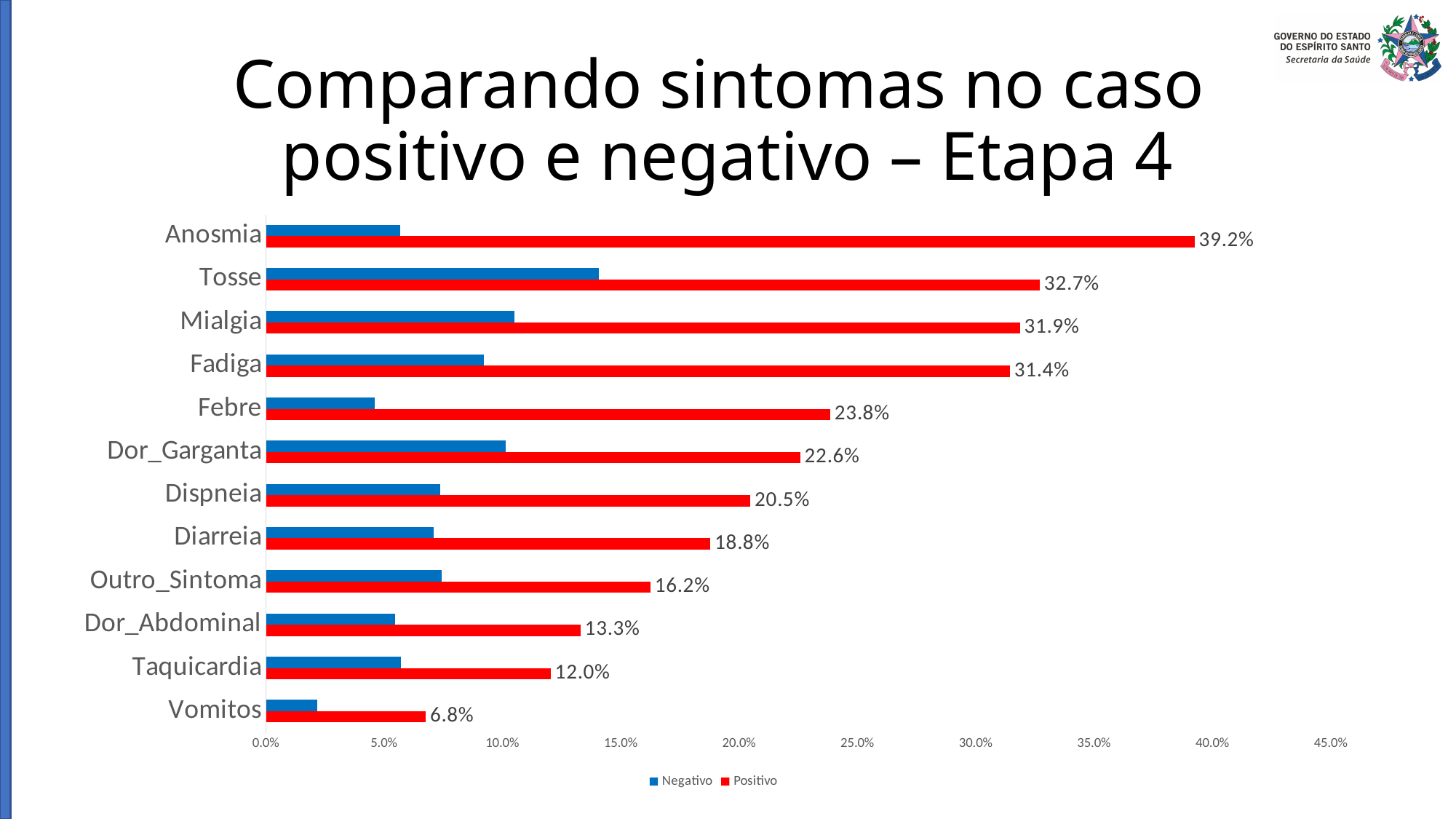
Is the Negativo value for Vomitos greater or less than 5.0%? less Is the Negativo value for Tosse greater or less than 10.0%? greater Which has a larger Positivo value, Dispneia or Diarreia? Dispneia How many symptoms are listed on the chart? 12 What kind of chart is shown on the slide? Bar chart Which symptom has the lowest Positivo value? Vomitos What is the Positivo value for Febre? 23.8% How many series does the legend list? 2 What is the difference between the Positivo values for Anosmia and Tosse? 6.5% What is the Positivo value for Vomitos? 6.8% Which symptom has the highest Positivo value? Anosmia What is the Positivo value for Anosmia? 39.2%